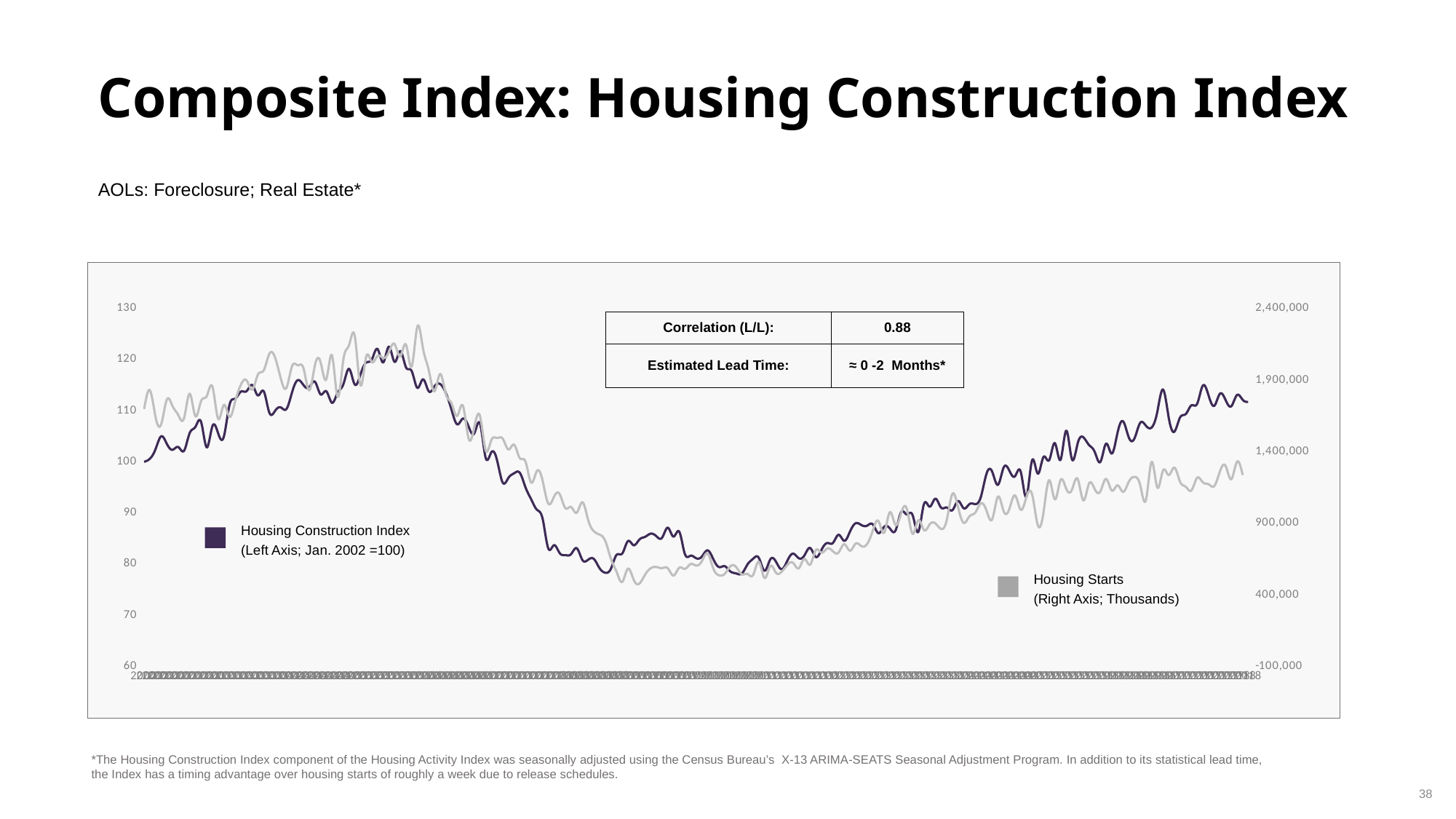
How many series does the chart's legend list? 2 Is the value of Housing Starts at the right end of the chart greater or less than 1,400,000? less Is the lowest value reached by Housing Starts greater or less than 900,000? less What kind of chart is shown on the slide? line chart Is the value of the Housing Construction Index at the right end of the chart greater or less than 100? greater What is the Correlation (L/L) value shown in the table on the chart? 0.88 What is the Estimated Lead Time shown in the table on the chart? ≈ 0 -2 Months*